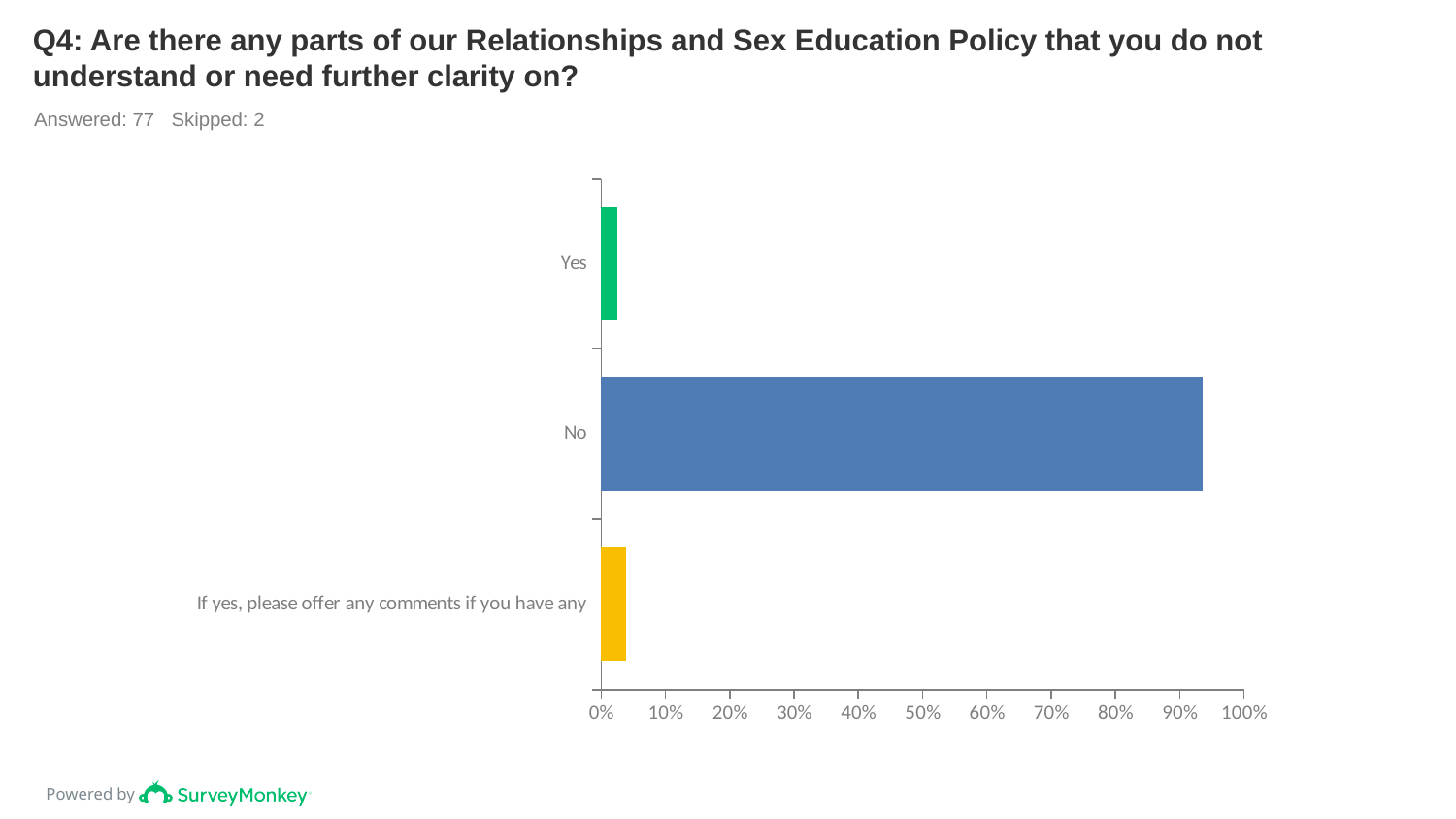
What kind of chart is shown on the slide? bar chart Is the value for No greater or less than 90%? greater Which category has the highest value in the chart? No What colour is the bar for No? blue Is the value for Yes greater or less than 10%? less Which is larger, the value for No or the value for Yes? No How many categories are plotted in the chart? 3 What is the highest value shown on the x axis of the chart? 100% Is the value for No greater or less than 80%? greater